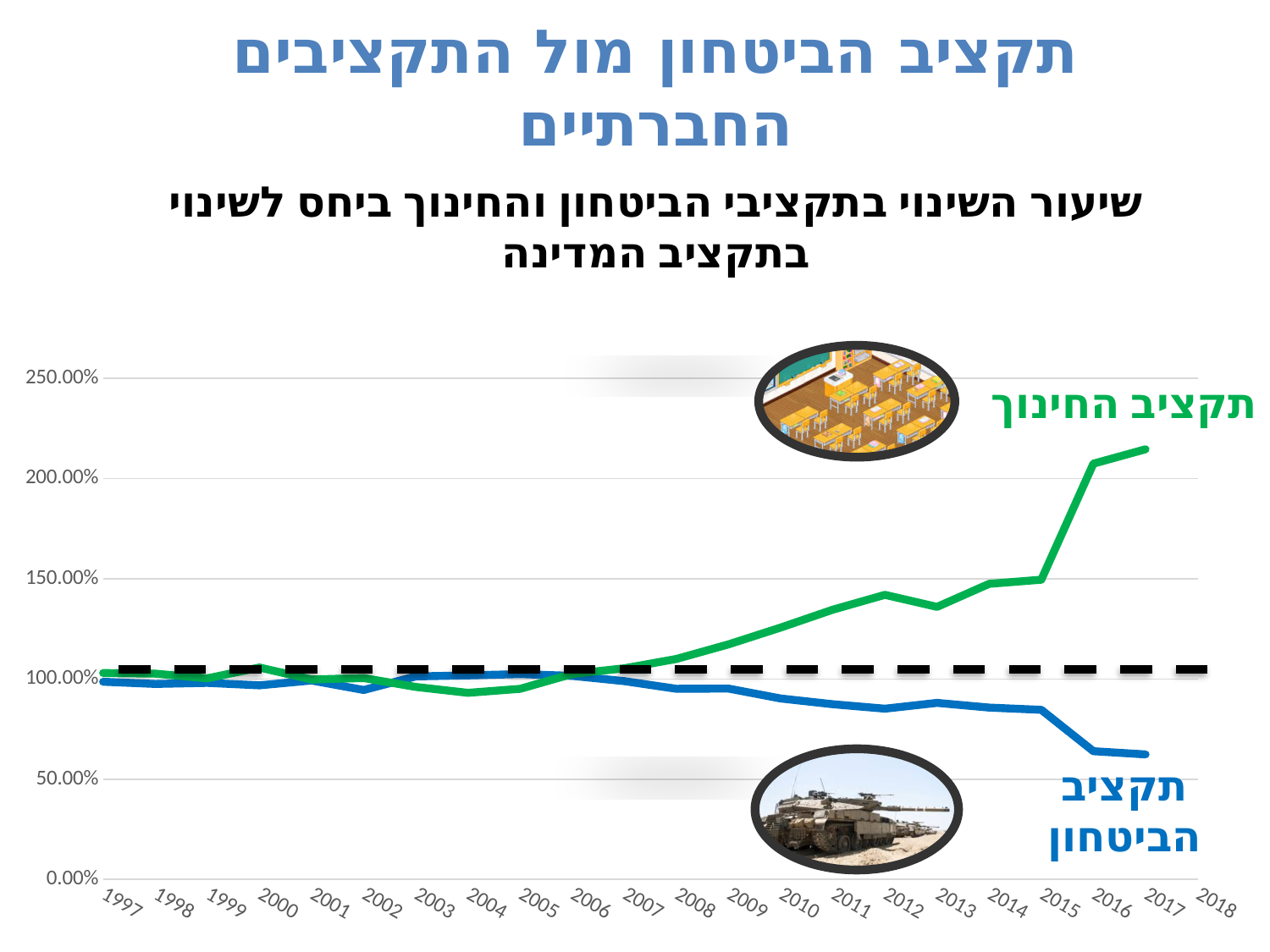
Is the value of the security budget line (תקציב הביטחון) in 2016 greater or less than 50.00%? greater Is the value of the education budget line (תקציב החינוך) in 2012 greater or less than 150.00%? less Is the value of the education budget line (תקציב החינוך) in 2017 greater or less than 200.00%? greater Does the security budget line (תקציב הביטחון) generally rise or fall from 2007 to 2017? fall How many year labels appear on the x axis of the chart? 22 What is the first year shown on the x axis of the chart? 1997 How many data series are plotted on the chart? 2 What colour is the line for the education budget (תקציב החינוך)? green Does the education budget line (תקציב החינוך) generally rise or fall from 2007 to 2017? rise What kind of chart is shown on the slide? line chart Which series has the higher value in 2017, the education budget (תקציב החינוך) or the security budget (תקציב הביטחון)? תקציב החינוך